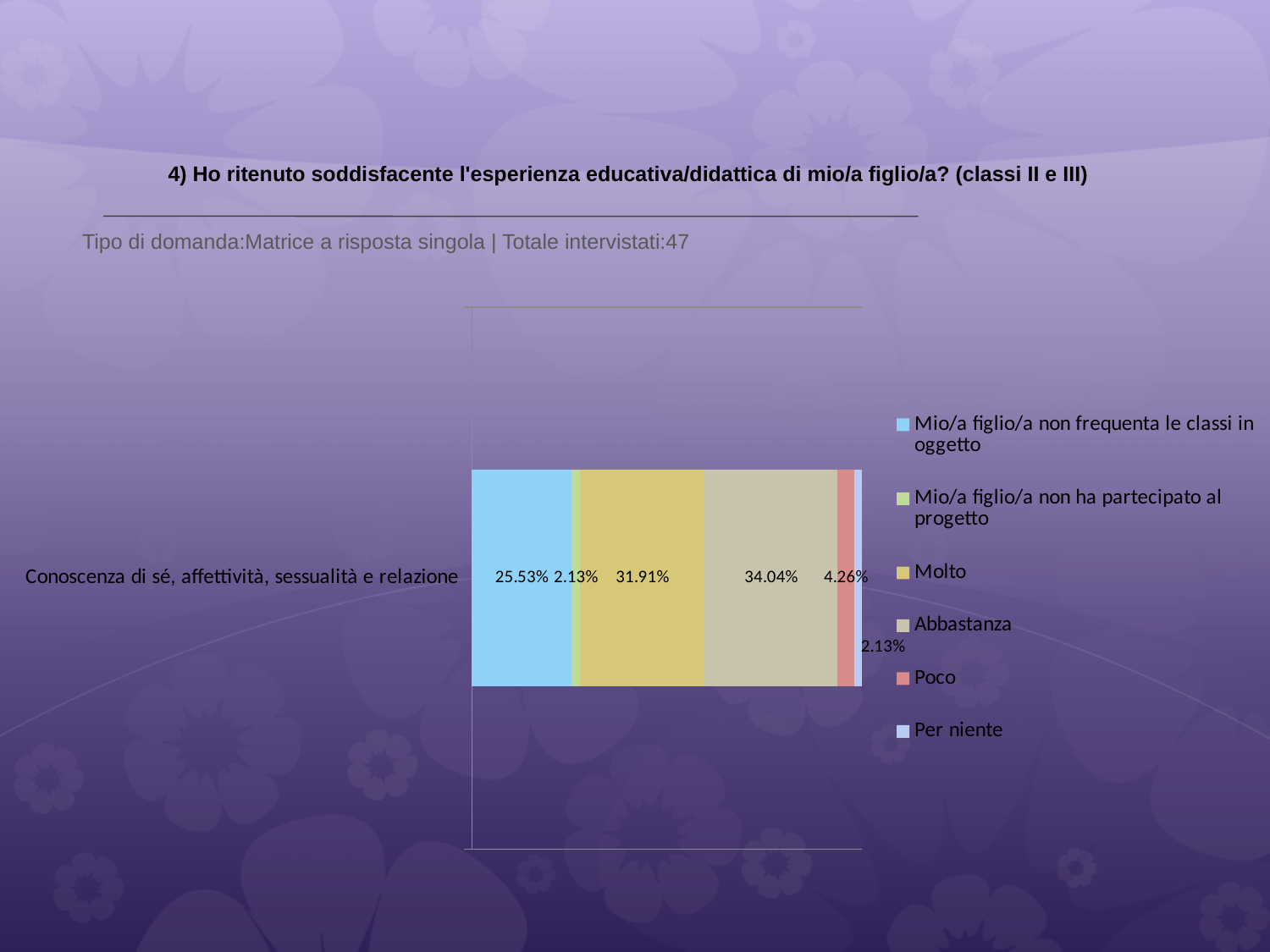
How many series does the legend list? 6 What is the value for "Molto" in the category "Conoscenza di sé, affettività, sessualità e relazione"? 31.91% Which is larger, the value for "Molto" or the value for "Mio/a figlio/a non frequenta le classi in oggetto"? Molto What is the value for "Per niente"? 2.13% What is the difference between the values for "Abbastanza" and "Molto"? 2.13% How many categories are plotted on the chart? 1 What kind of chart is shown on the slide? Stacked bar chart What is the value for "Abbastanza"? 34.04% What is the value for "Mio/a figlio/a non frequenta le classi in oggetto"? 25.53% What is the value for "Poco"? 4.26% What is the label of the single category shown on the chart? Conoscenza di sé, affettività, sessualità e relazione Which series has the highest value? Abbastanza